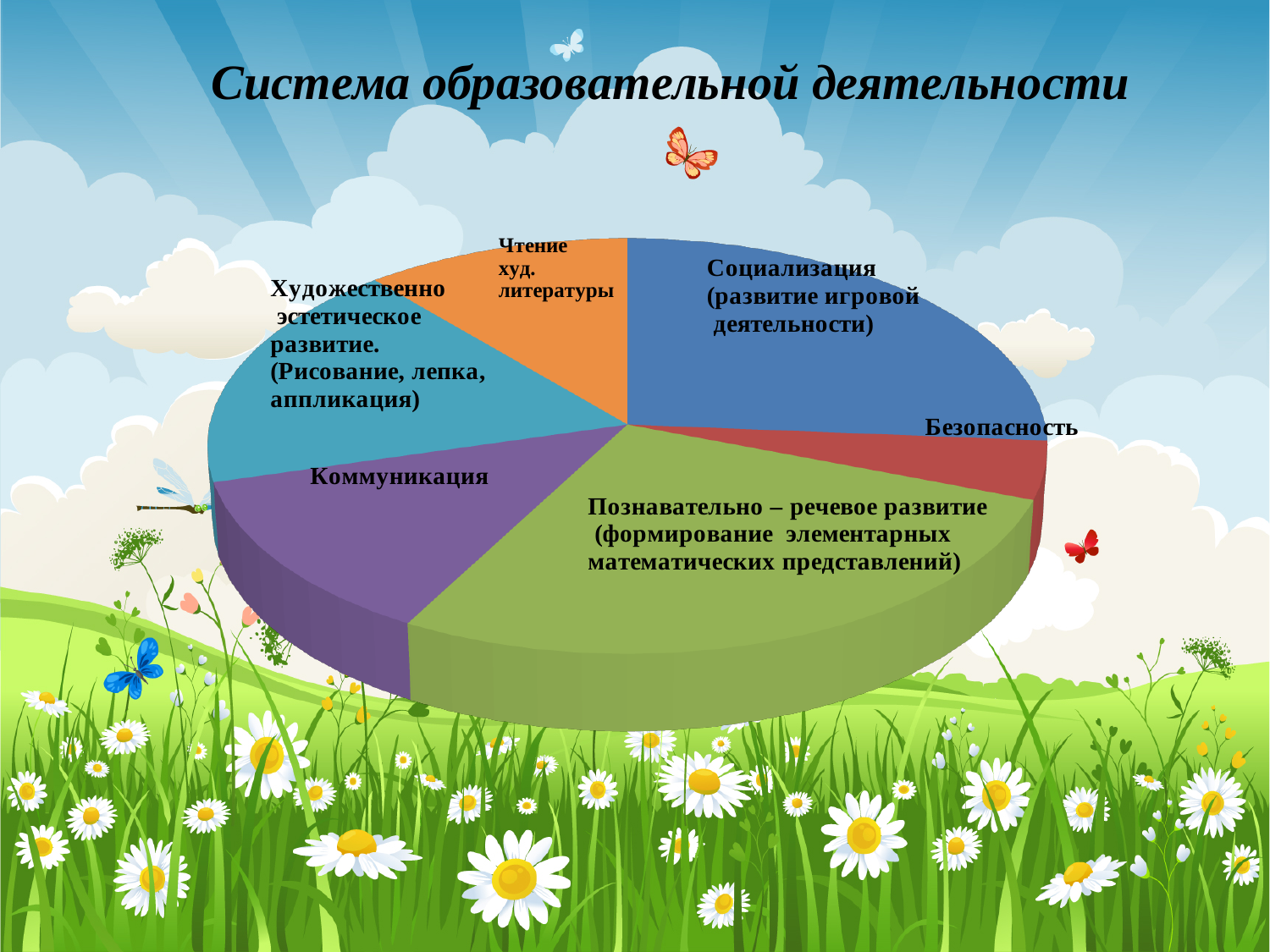
Which slice is larger: Познавательно – речевое развитие or Социализация? Познавательно – речевое развитие How many slices does the pie chart have? 6 Which category has the smallest slice of the pie chart? Безопасность What is the title of the slide containing the pie chart? Система образовательной деятельности Which category has the largest slice of the pie chart? Познавательно – речевое развитие (формирование элементарных математических представлений) What colour is the Безопасность slice of the pie chart? Red Which slice is larger: Социализация or Безопасность? Социализация What kind of chart is shown on the slide? Pie chart Which slice is larger: Художественно эстетическое развитие or Чтение худ. литературы? Художественно эстетическое развитие